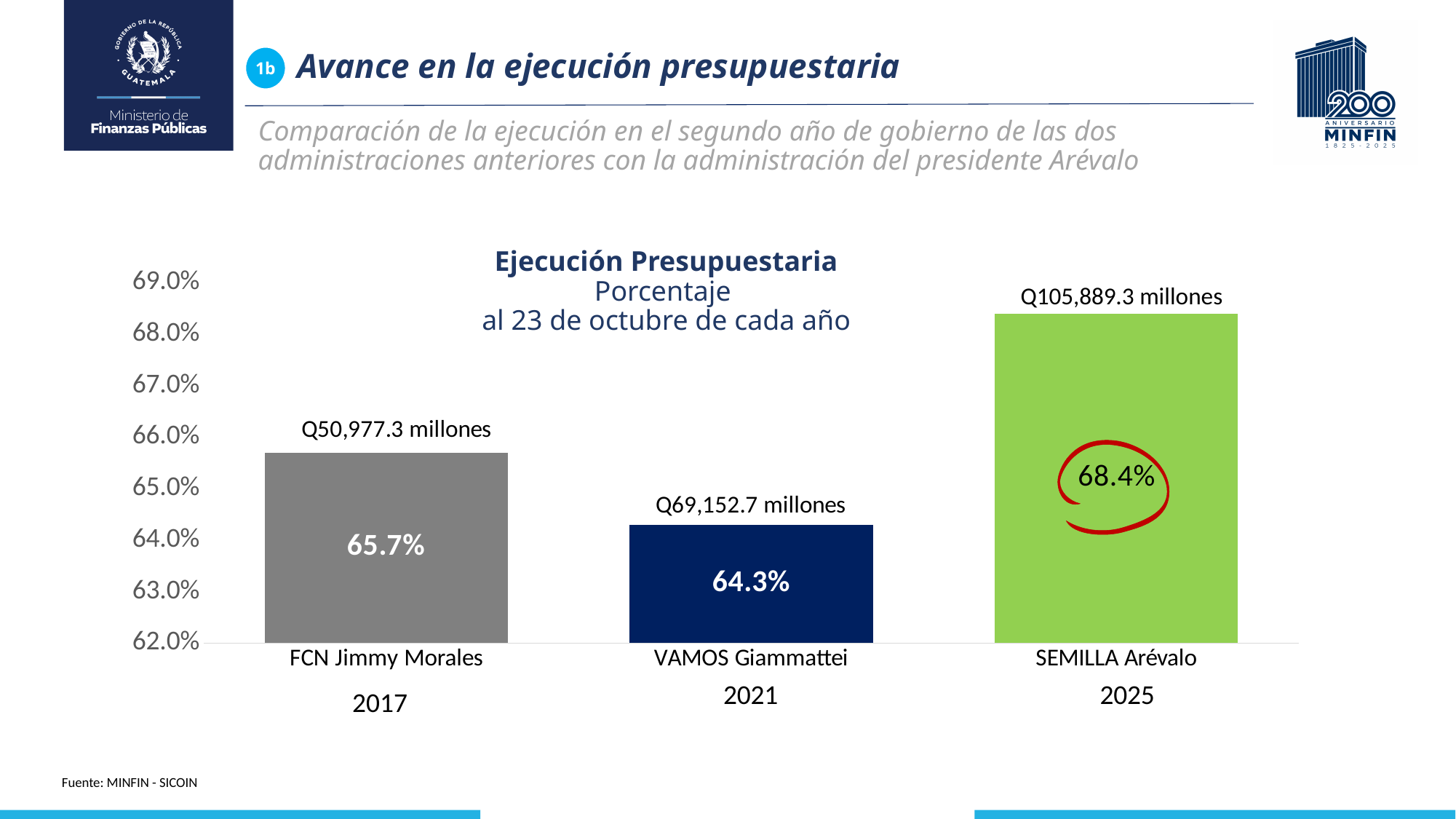
Which administration has the lowest budget execution percentage? VAMOS Giammattei What is the title of the chart? Ejecución Presupuestaria What amount in millones is shown above the SEMILLA Arévalo bar? Q105,889.3 millones What is the difference in percentage points between SEMILLA Arévalo and FCN Jimmy Morales? 2.7 Which administration has the highest budget execution percentage? SEMILLA Arévalo What is the budget execution percentage for FCN Jimmy Morales (2017)? 65.7% What amount in millones is shown above the VAMOS Giammattei bar? Q69,152.7 millones Which has a higher execution percentage, FCN Jimmy Morales or VAMOS Giammattei? FCN Jimmy Morales How many administrations (bars) are shown in the chart? 3 What type of chart is shown on the slide? Bar chart What is the budget execution percentage for VAMOS Giammattei (2021)? 64.3% What is the budget execution percentage for SEMILLA Arévalo (2025)? 68.4%